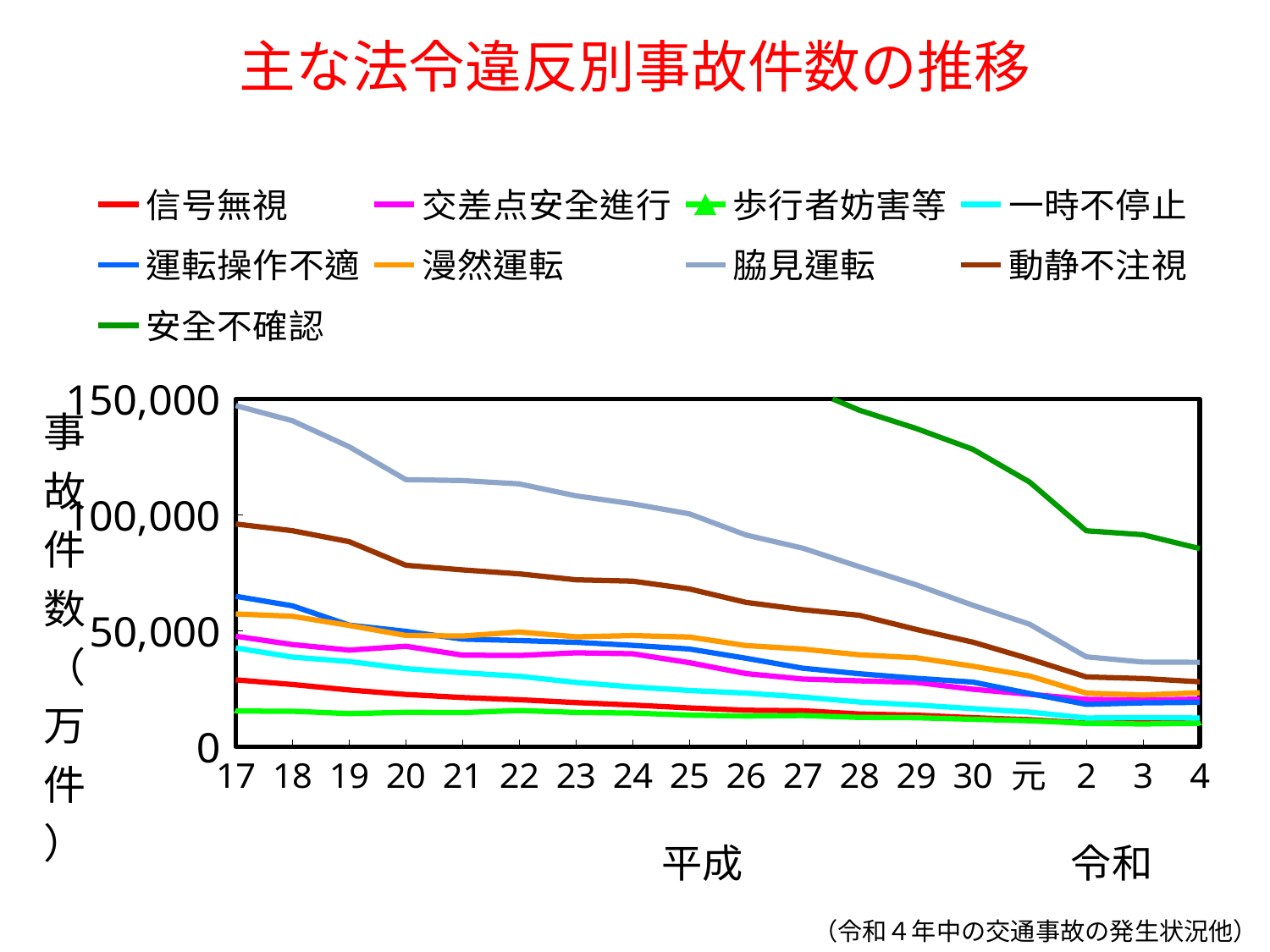
Is the value for 運転操作不適 at 平成17 greater or less than 50,000? greater Which series has the lowest value at 平成17? 歩行者妨害等 Is the value for 安全不確認 at 令和4 greater or less than 100,000? less At 平成17, which is larger: 脇見運転 or 動静不注視? 脇見運転 What is the title of the chart? 主な法令違反別事故件数の推移 What kind of chart is shown on the slide? line chart Which series has the highest value at 令和4? 安全不確認 Is the value for 信号無視 at 平成17 greater or less than 50,000? less Does the 脇見運転 series rise or fall from 平成17 to 令和4? fall How many points (years) are shown along the x axis? 18 How many series does the legend list? 9